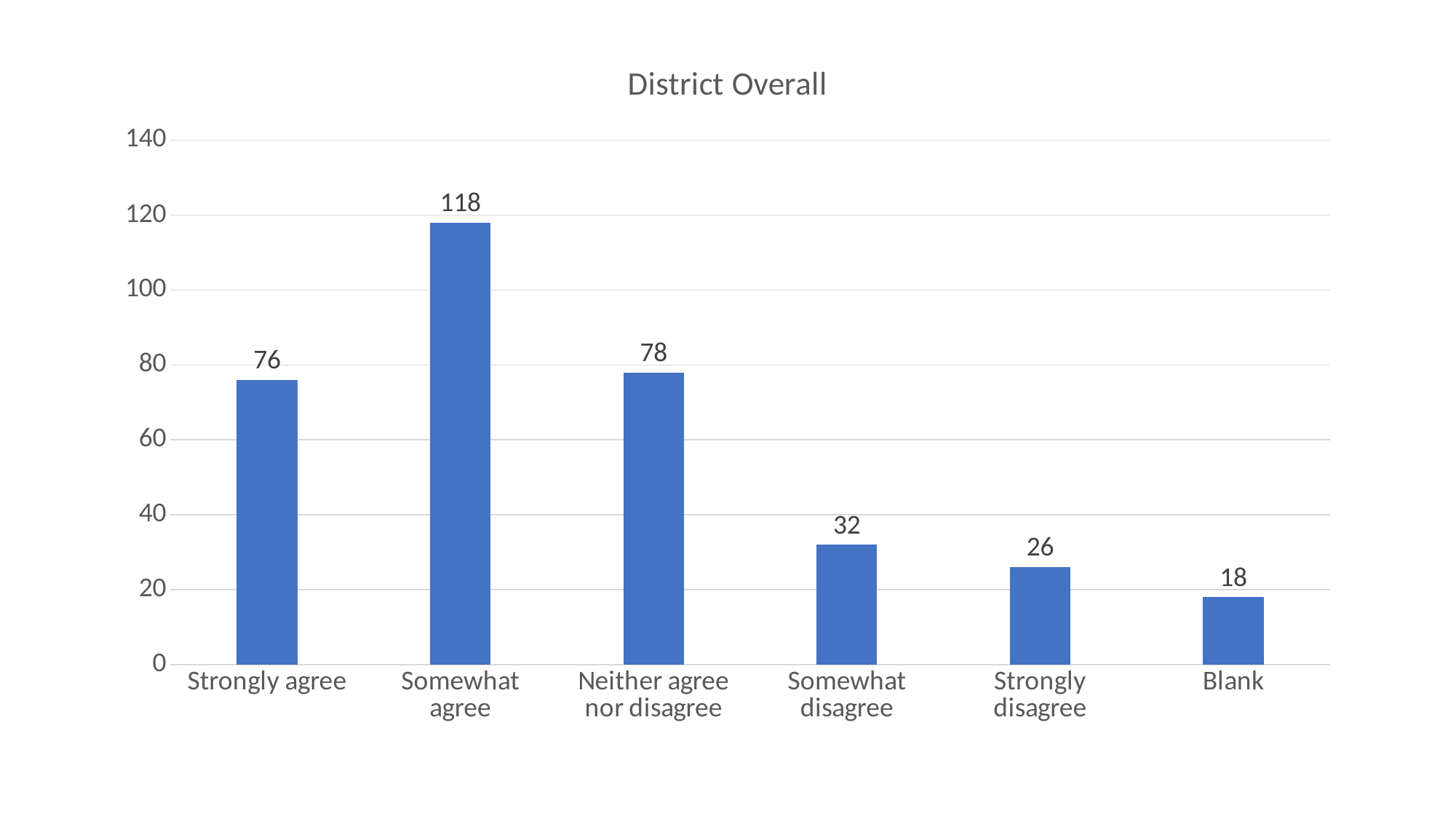
How many categories are shown on the x axis? 6 What is the title of the chart? District Overall Is the value for Neither agree nor disagree greater or less than 60? greater What is the value for Strongly disagree? 26 What is the value for Blank? 18 What is the value for Somewhat agree? 118 Which is larger, the value for Strongly agree or the value for Somewhat disagree? Strongly agree Which category has the lowest value? Blank What is the difference between the values for Somewhat agree and Neither agree nor disagree? 40 Which category has the highest value? Somewhat agree What is the value for Strongly agree? 76 What is the difference between the values for Somewhat disagree and Strongly disagree? 6